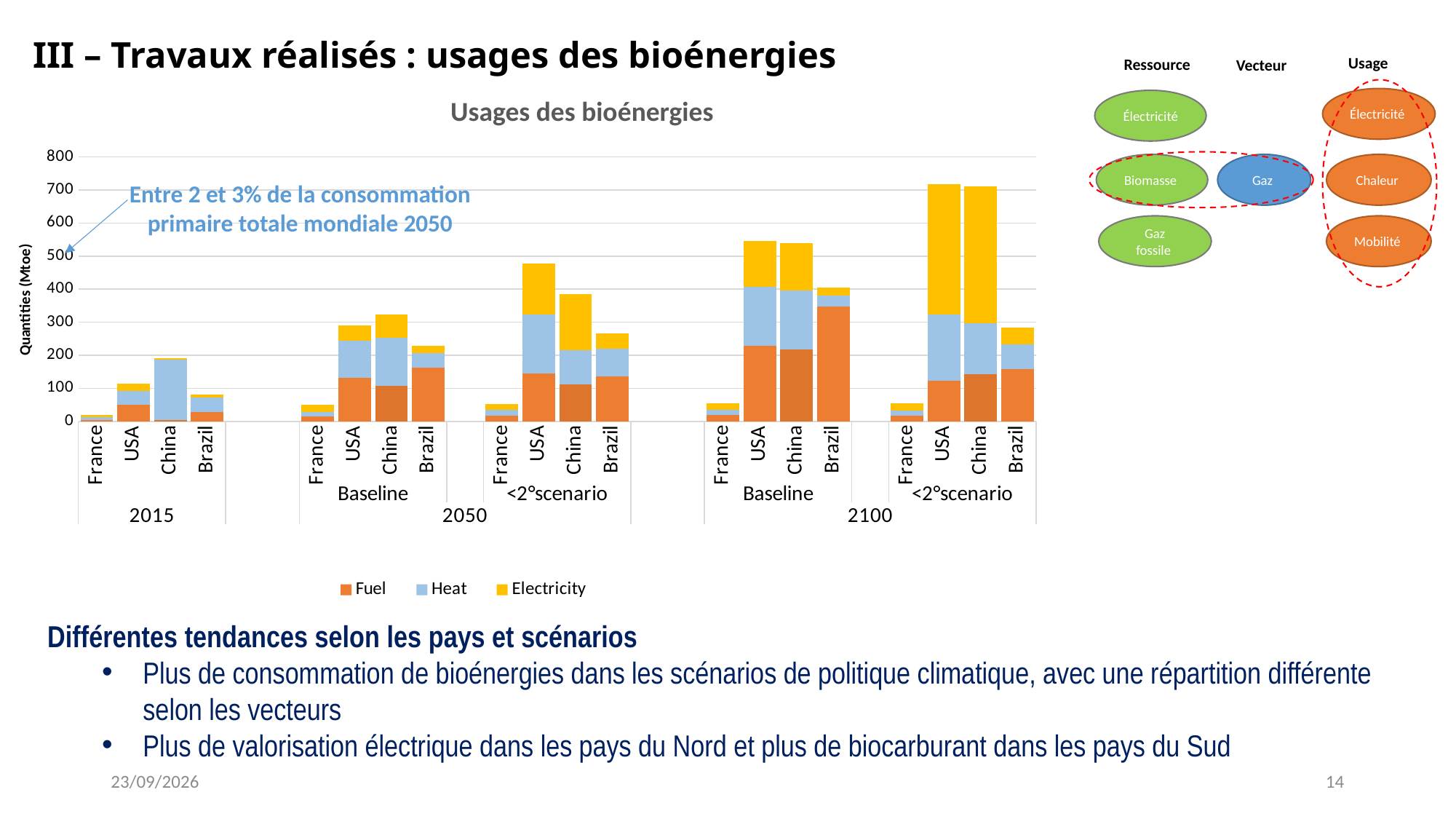
How many countries are shown within each scenario group on the x axis? 4 Does the total for USA rise or fall moving from 2015 through the 2050 scenarios to the 2100 scenarios? rise Which bar has the lowest total on the chart? France in 2015 How many series does the legend of the 'Usages des bioénergies' chart list? 3 What kind of chart is shown under the title 'Usages des bioénergies'? Stacked bar chart Is the total for USA in the 2050 <2°scenario greater or less than 400? greater In the 2050 <2°scenario, which has the larger total, USA or China? USA Is the total for China in 2015 greater or less than 100? greater How many stacked bars are plotted in total on the chart? 20 What are the three series listed in the legend of the chart? Fuel, Heat, Electricity Is the total for France in the 2050 Baseline greater or less than 100? less What is the label of the vertical axis of the chart? Quantities (Mtoe)